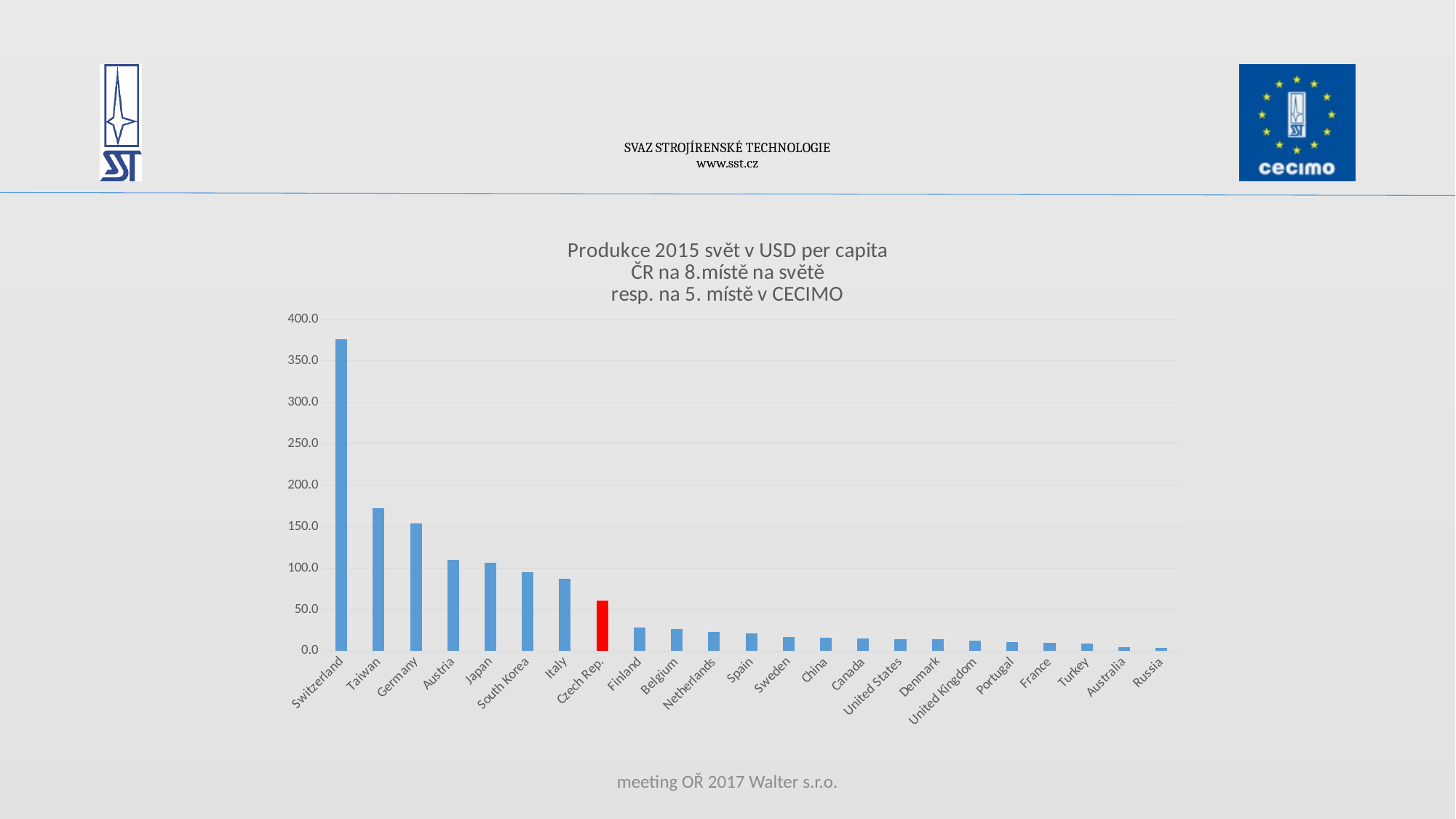
What kind of chart is shown on the slide? bar chart Do the values rise or fall moving from left to right along the x axis? fall Which country's bar is coloured red in the chart? Czech Rep. Which has a larger value, Taiwan or Germany? Taiwan How many countries are shown on the x axis of the chart? 23 Is the value for Italy greater or less than 100? less Is the value for Czech Rep. greater or less than 50? greater Which country has the highest value in the chart? Switzerland Is the value for Switzerland greater or less than 350? greater Which has a larger value, Czech Rep. or Finland? Czech Rep.